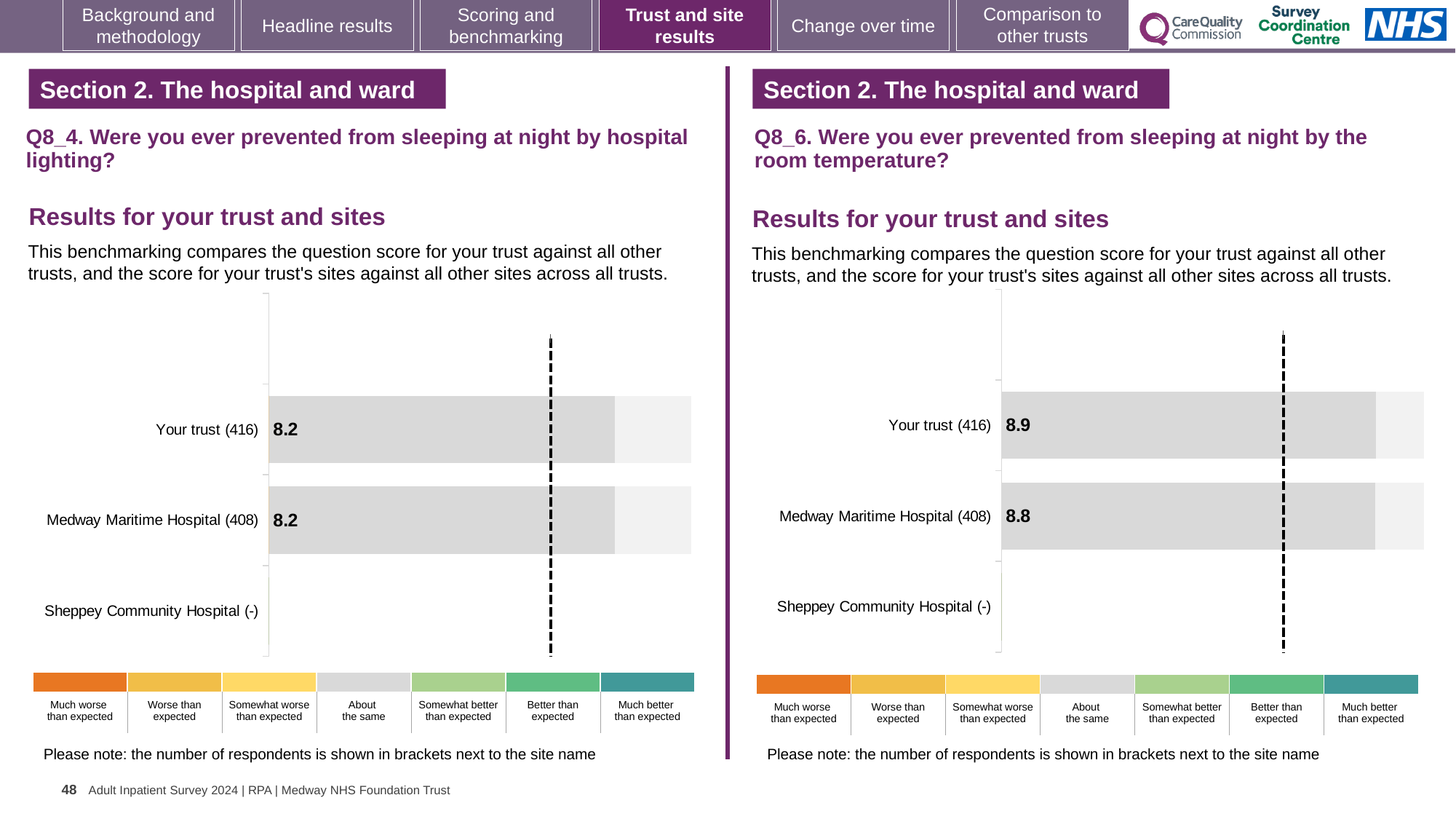
In the Q8_4 chart (hospital lighting), what is the score for Medway Maritime Hospital (408)? 8.2 In the Q8_6 chart (room temperature), what is the score for Your trust (416)? 8.9 In the Q8_6 chart (room temperature), which has the higher score: Your trust (416) or Medway Maritime Hospital (408)? Your trust (416) In the Q8_4 chart (hospital lighting), which category has no score shown? Sheppey Community Hospital (-) How many benchmark categories are shown in the colour legend below the Q8_6 chart (room temperature)? 7 In the Q8_4 chart (hospital lighting), how many site/trust categories are listed on the vertical axis? 3 What kind of chart is used in the Q8_4 chart (hospital lighting)? Bar chart In the Q8_4 chart (hospital lighting), what is the score for Your trust (416)? 8.2 In the Q8_6 chart (room temperature), what is the score for Medway Maritime Hospital (408)? 8.8 In the Q8_6 chart (room temperature), what is the difference between the score for Your trust (416) and the score for Medway Maritime Hospital (408)? 0.1 Is the score for Your trust in the Q8_6 chart (room temperature) higher or lower than the score for Your trust in the Q8_4 chart (hospital lighting)? Higher